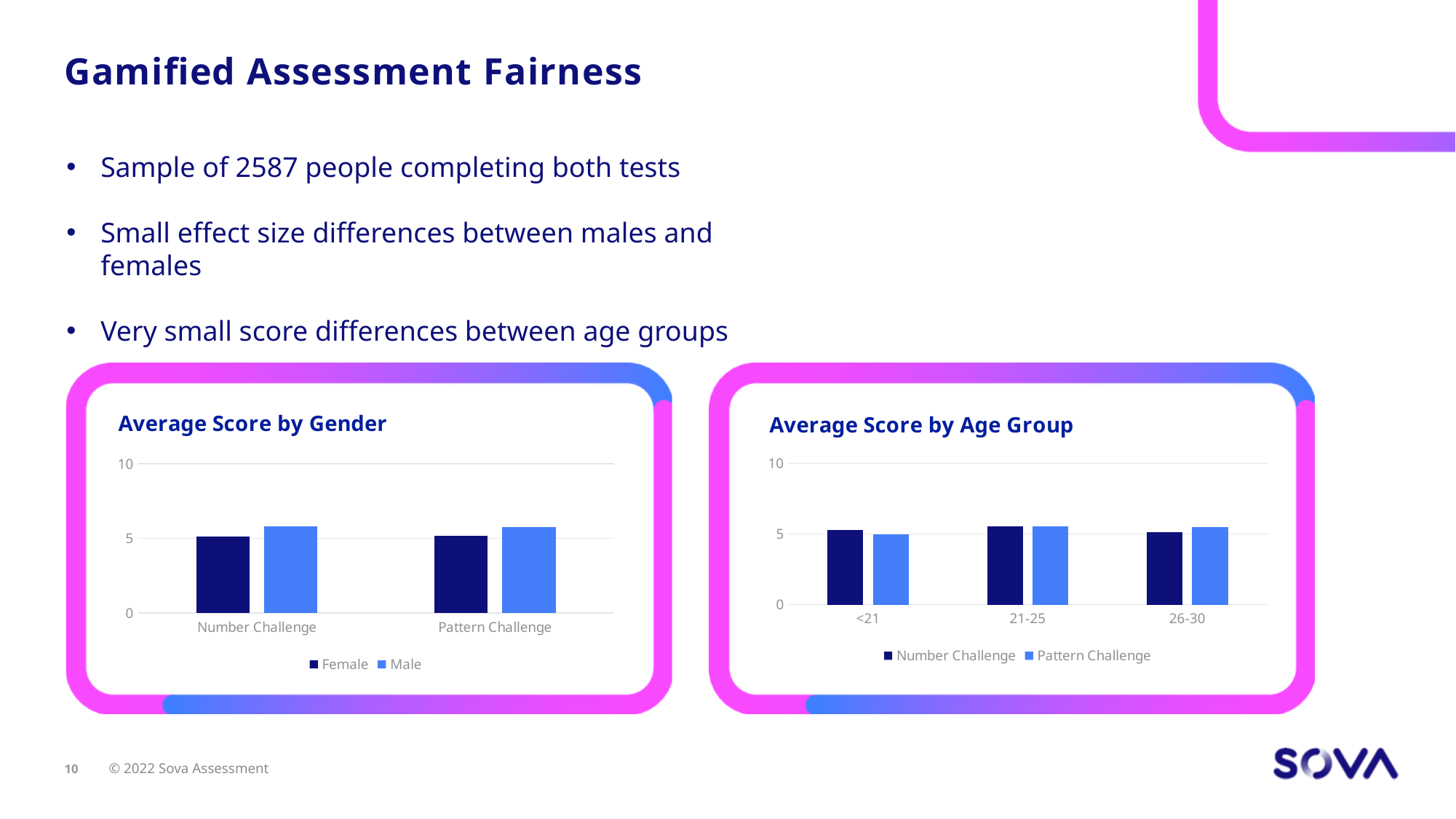
What are the two series listed in the legend of the "Average Score by Age Group" chart? Number Challenge and Pattern Challenge How many age group categories are shown on the x axis of the "Average Score by Age Group" chart? 3 In the "Average Score by Gender" chart, is the Male value for the Number Challenge greater or less than 5? greater What kind of chart is the "Average Score by Age Group" chart? bar chart In the "Average Score by Gender" chart, which is larger for the Pattern Challenge, the Female or the Male bar? Male How many categories are shown on the x axis of the "Average Score by Gender" chart? 2 How many series does the legend of the "Average Score by Gender" chart list? 2 In the "Average Score by Age Group" chart, which is larger for the <21 group, the Number Challenge or the Pattern Challenge bar? Number Challenge What kind of chart is the "Average Score by Gender" chart? bar chart In the "Average Score by Age Group" chart, is the Number Challenge value for the 21-25 group greater or less than 10? less In the "Average Score by Gender" chart, which is larger for the Number Challenge, the Female or the Male bar? Male